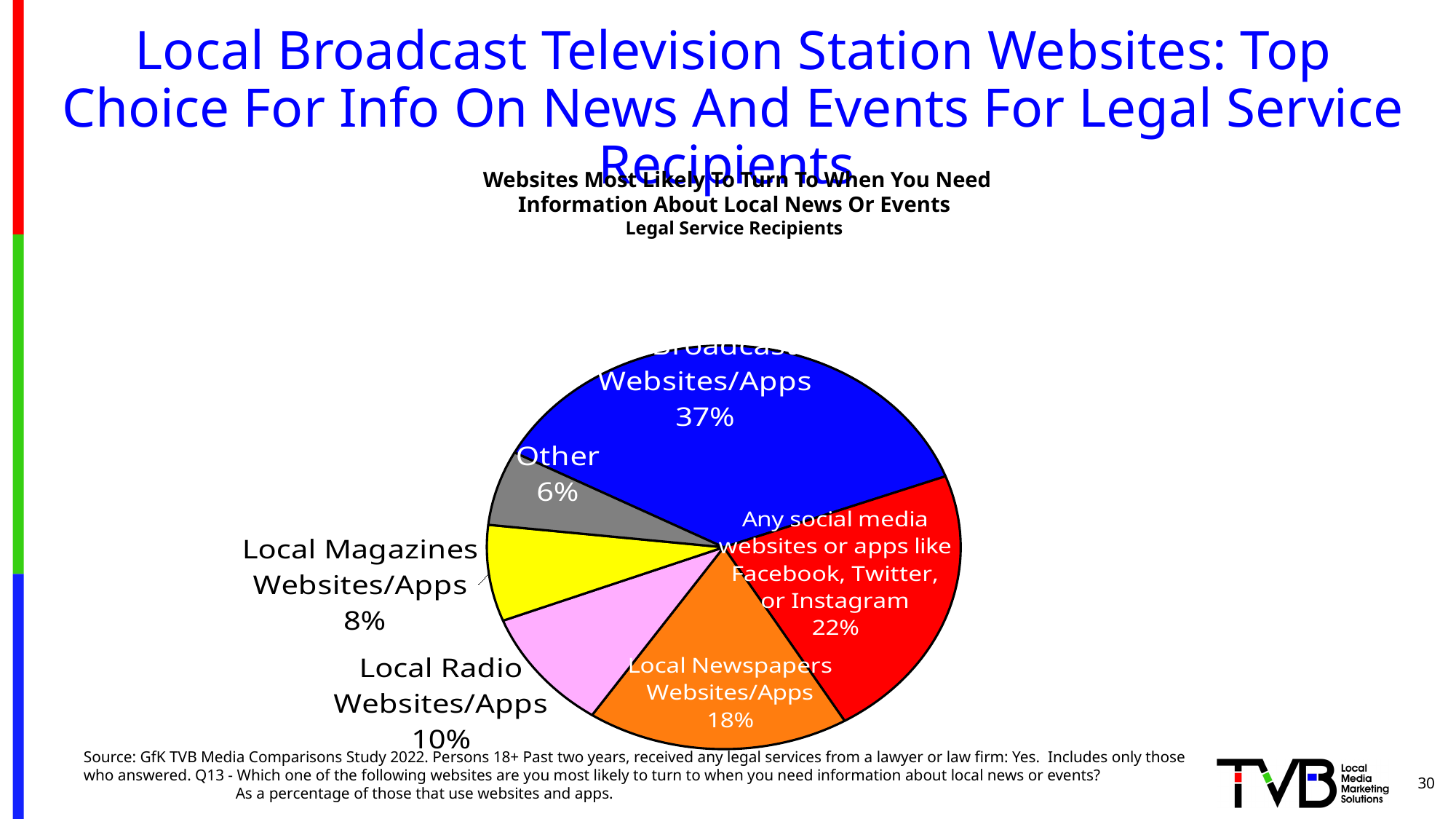
What percentage is shown for Local Radio Websites/Apps? 10% What percentage is shown for Local Newspapers Websites/Apps? 18% What colour is the 'Other' slice in the pie chart? Gray What type of chart is shown on the slide? Pie chart What percentage is shown for 'Any social media websites or apps like Facebook, Twitter, or Instagram'? 22% What percentage is shown for Local Magazines Websites/Apps? 8% What percentage is shown for the 'Other' slice? 6% What is the difference between the social media slice and the Local Newspapers Websites/Apps slice? 4 percentage points Which slice of the pie chart is the smallest? Other What percentage is shown on the largest slice of the pie chart? 37% How many slices does the pie chart have? 6 Which is larger: Local Radio Websites/Apps or Local Magazines Websites/Apps? Local Radio Websites/Apps